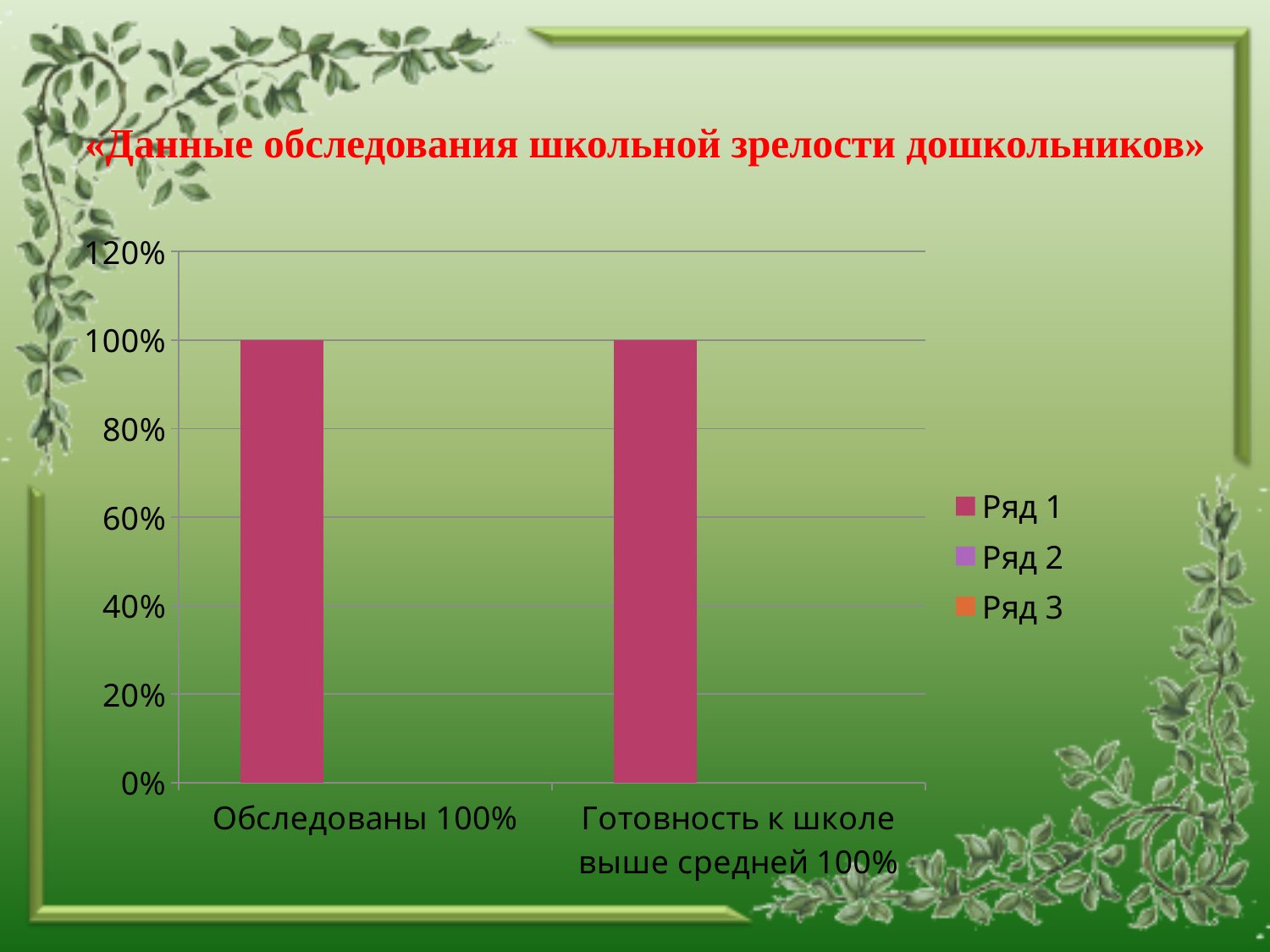
Which legend entry corresponds to the plotted bars? Ряд 1 What is the title of the chart? «Данные обследования школьной зрелости дошкольников» How many categories are shown on the x axis? 2 Is the value for "Обследованы 100%" greater or less than 80%? greater What is the highest value shown on the y axis? 120% How many series does the legend list? 3 What is the difference between the values for "Обследованы 100%" and "Готовность к школе выше средней 100%"? 0% What is the value of the bar for "Обследованы 100%"? 100% Is the value for "Готовность к школе выше средней 100%" greater or less than 120%? less What is the value of the bar for "Готовность к школе выше средней 100%"? 100% What type of chart is shown on the slide? bar chart